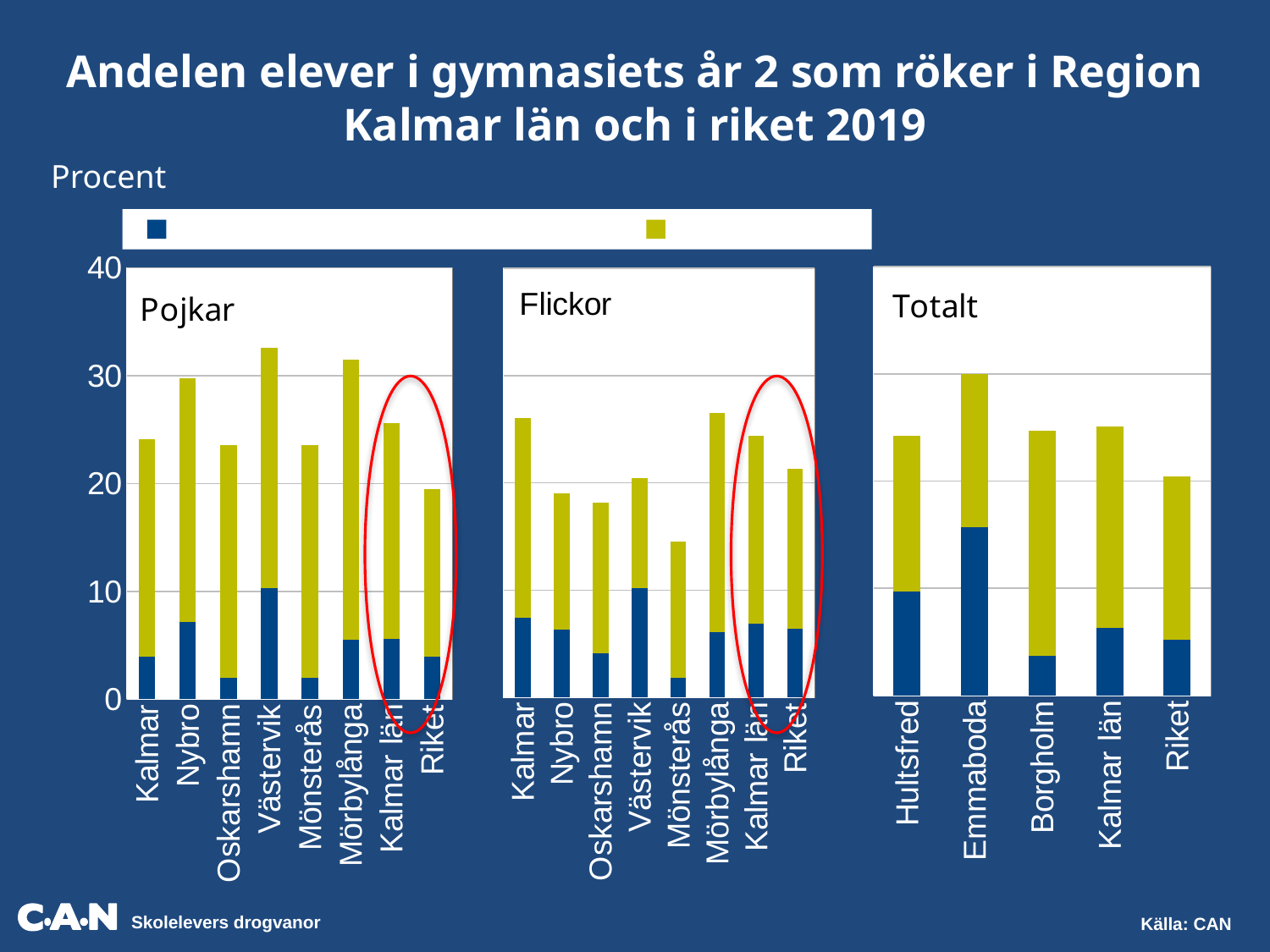
In the Pojkar chart, which has the larger total bar, Nybro or Kalmar? Nybro In the Pojkar chart, which category has the lowest total bar? Riket What kind of chart is the Pojkar chart? bar chart How many series does the legend list? 2 How many categories are shown on the x axis of the Pojkar chart? 8 How many categories are shown on the x axis of the Totalt chart? 5 In the Totalt chart, which category has the lowest total bar? Riket What is the label shown above the y axis of the charts? Procent In the Flickor chart, which category has the lowest total bar? Mönsterås In the Pojkar chart, is the total value for Västervik greater or less than 30? greater In the Totalt chart, which category has the highest total bar? Emmaboda In the Flickor chart, is the total value for Mönsterås greater or less than 20? less